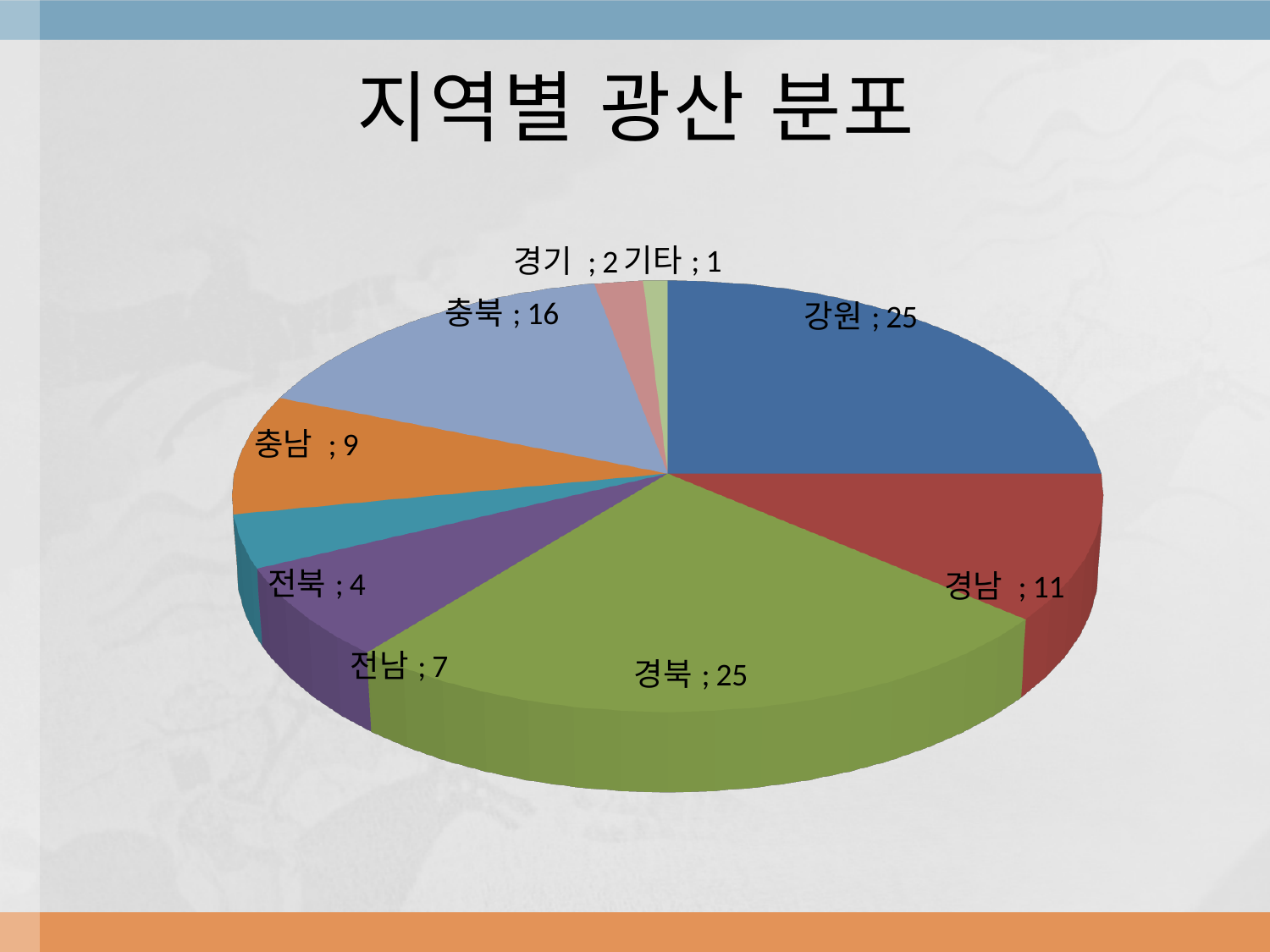
What is the value for 강원? 25 What is the difference between the values for 충북 and 충남? 7 What share of the pie does 충남 represent? 9% What is the total of all the slices in the pie chart? 100 What is the value for 충북? 16 What is the title of the chart? 지역별 광산 분포 What share of the pie does 경북 represent? 25% What is the value for 전북? 4 What kind of chart is shown on the slide? pie chart Which region has the smallest slice? 기타 Which is larger, the value for 경남 or the value for 전남? 경남 How many slices does the pie chart have? 9